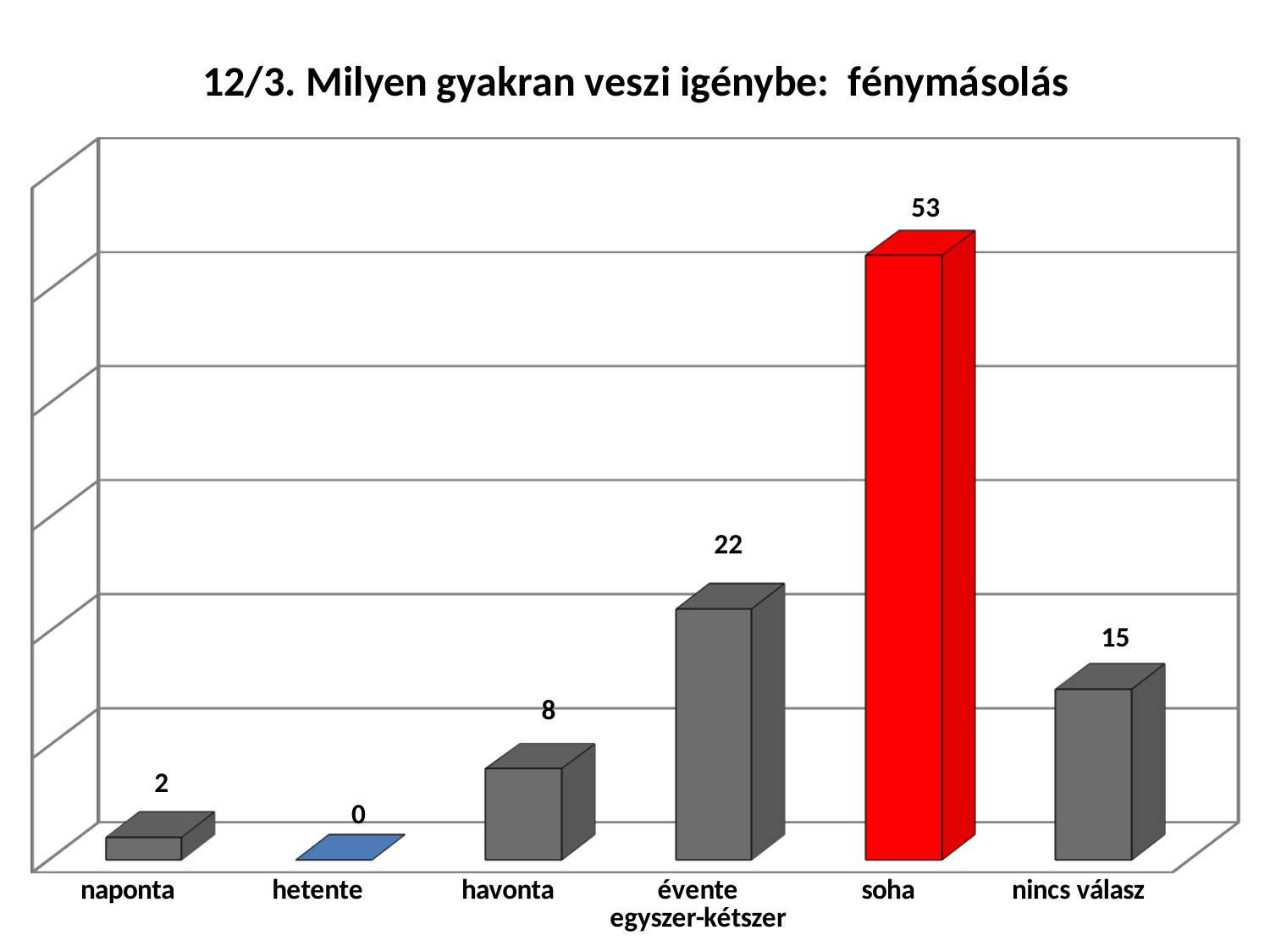
What is the value for "nincs válasz"? 15 Which category has the highest value? soha What is the value for "soha"? 53 What is the value for "hetente"? 0 Which is larger, the value for "nincs válasz" or the value for "havonta"? nincs válasz Which category has the lowest value? hetente How many categories are shown on the x axis? 6 What is the difference between the values for "havonta" and "naponta"? 6 What kind of chart is this? bar chart What is the value for "évente egyszer-kétszer"? 22 What is the difference between the values for "soha" and "évente egyszer-kétszer"? 31 What is the title of the chart? 12/3. Milyen gyakran veszi igénybe: fénymásolás